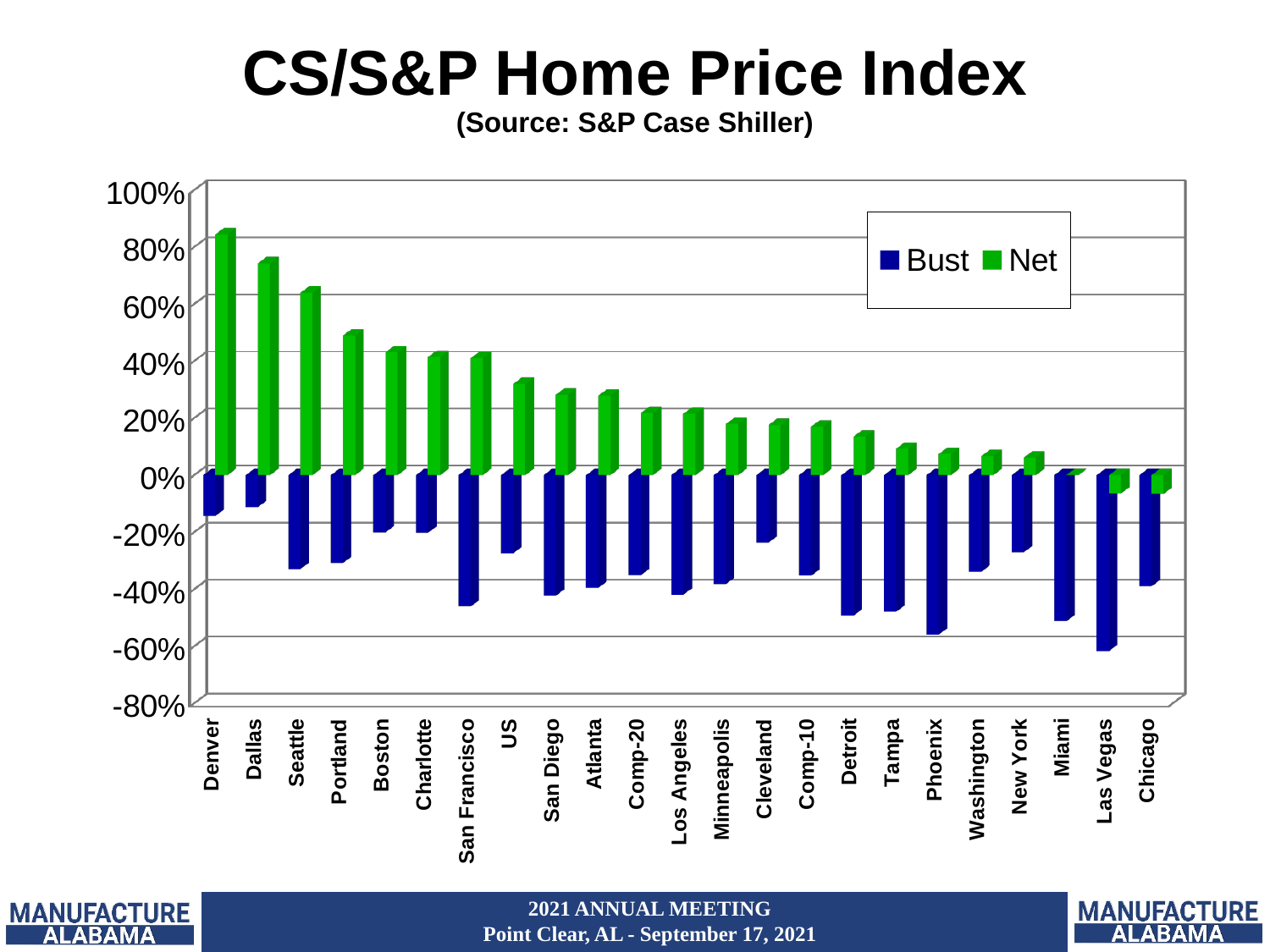
What kind of chart is shown on the slide? Bar chart How many series does the legend list? 2 Which is larger, the Net value for Denver or the Net value for Dallas? Denver Which category has the lowest (most negative) Bust value? Las Vegas Is the Net value for US greater or less than 20%? greater How many cities or composites are shown on the x axis? 23 Is the Bust value for Phoenix greater or less than -40%? less Which category has the highest Net value? Denver Do the Net values generally rise or fall moving from left to right along the x axis? Fall What are the two series named in the legend? Bust and Net Is the Bust value for Denver greater or less than -20%? greater